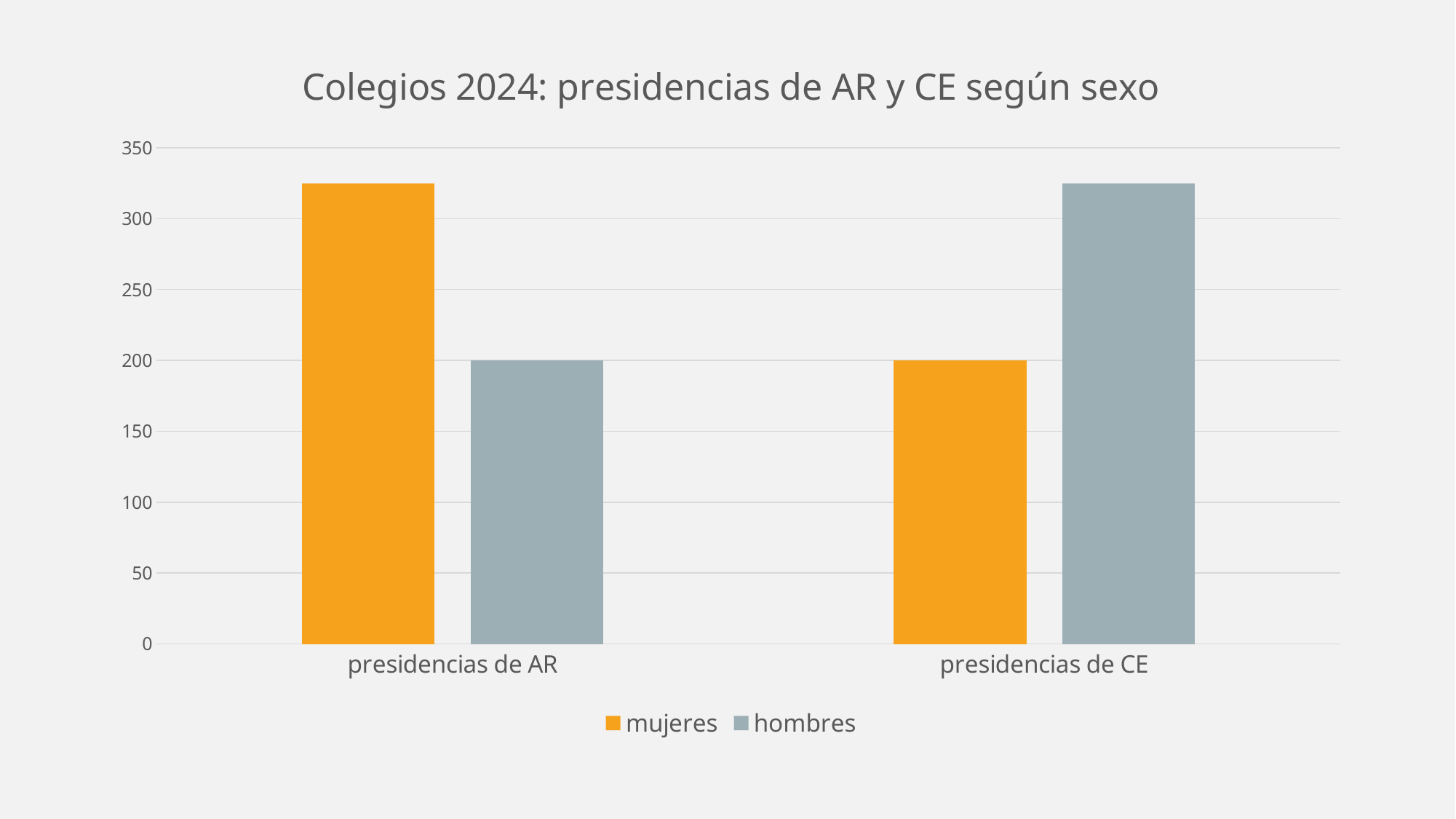
What is the title of the chart? Colegios 2024: presidencias de AR y CE según sexo In presidencias de CE, which series has the larger value, mujeres or hombres? hombres How many series does the legend list? 2 What kind of chart is shown on the slide? bar chart Is the value for mujeres in presidencias de AR greater or less than 300? greater In which category is the value for mujeres highest? presidencias de AR Is the value for hombres in presidencias de CE greater or less than 350? less What is the value for mujeres in presidencias de CE? 200 In presidencias de AR, which series has the larger value, mujeres or hombres? mujeres Which colour represents the hombres series? grey How many categories are shown on the x axis? 2 What is the value for hombres in presidencias de AR? 200